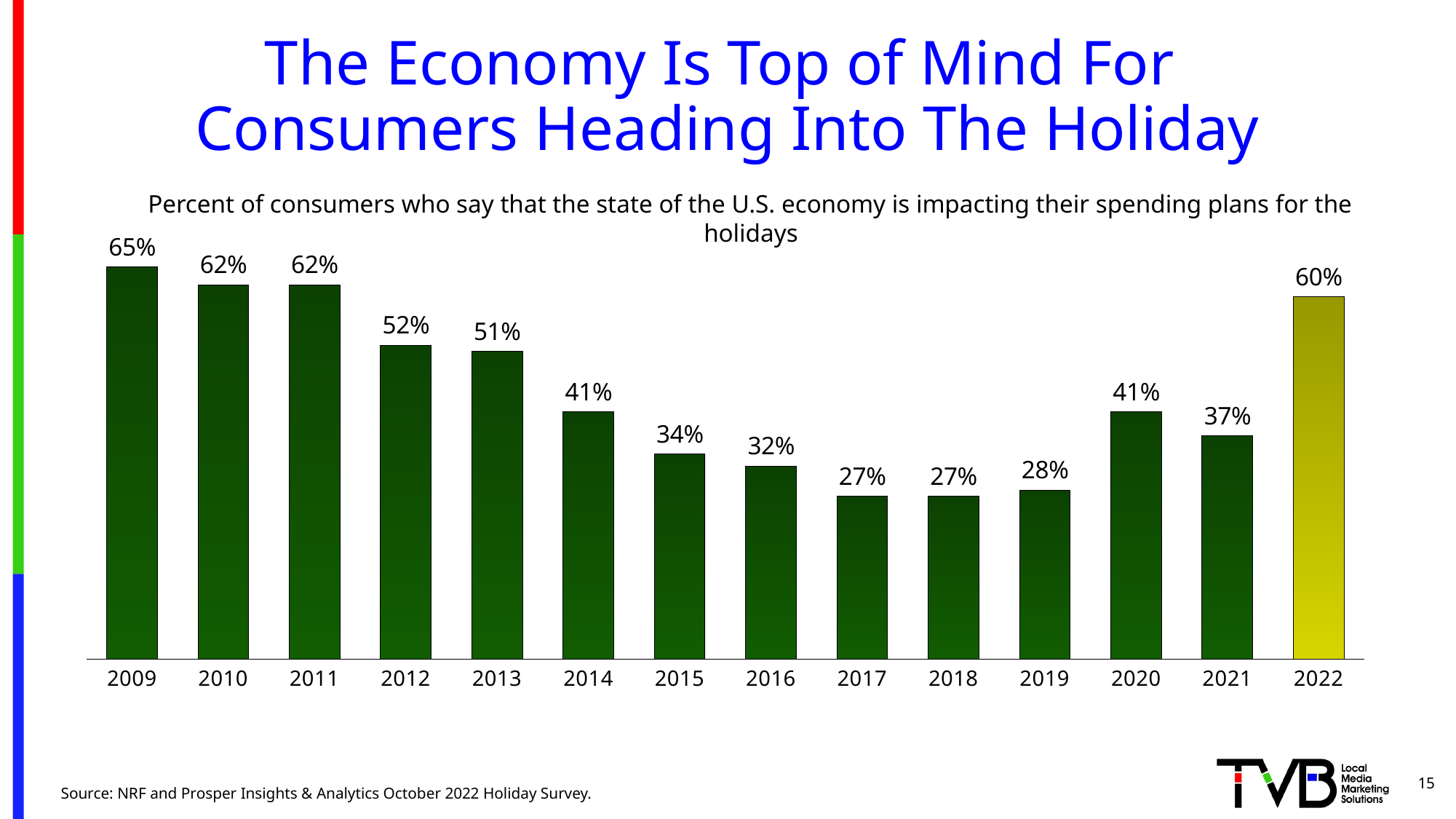
Which bar is shown in a different colour (yellow) from the others? 2022 What is the value shown for 2020? 41% Which year has the highest value on the chart? 2009 What is the difference between the 2009 value and the 2017 value? 38 percentage points How many years are shown on the x axis? 14 What percent of consumers said the state of the U.S. economy was impacting their holiday spending plans in 2022? 60% What is the value shown for 2015? 34% What is the lowest value shown on the chart? 27% Which is larger, the value for 2012 or the value for 2013? 2012 What is the difference between the 2022 value and the 2021 value? 23 percentage points What kind of chart is shown on the slide? Bar chart Do the values rise or fall from 2009 to 2017? Fall